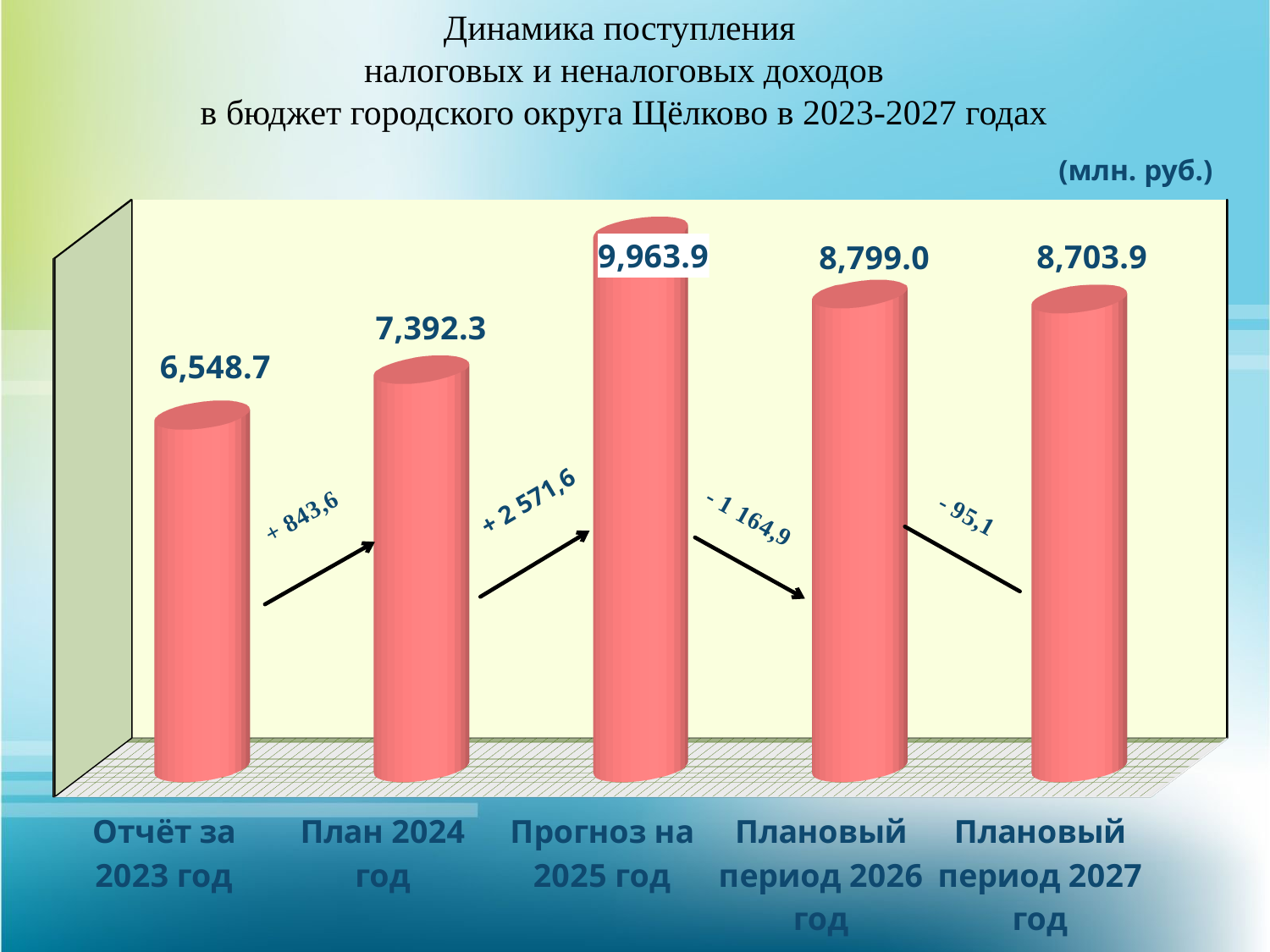
Do the values rise or fall from Прогноз на 2025 год to Плановый период 2027 год? Fall What kind of chart is shown on the slide? Bar chart What is the value for Отчёт за 2023 год? 6,548.7 What is the difference between the values for План 2024 год and Отчёт за 2023 год? 843.6 Which category has the highest value? Прогноз на 2025 год Which category has the lowest value? Отчёт за 2023 год What unit is indicated for the values in the chart? млн. руб. What is the difference between the values for Прогноз на 2025 год and Плановый период 2026 год? 1,164.9 What is the value for Прогноз на 2025 год? 9,963.9 Which is larger, the value for Плановый период 2026 год or Плановый период 2027 год? Плановый период 2026 год How many categories are shown in the chart? 5 What is the value for Плановый период 2027 год? 8,703.9